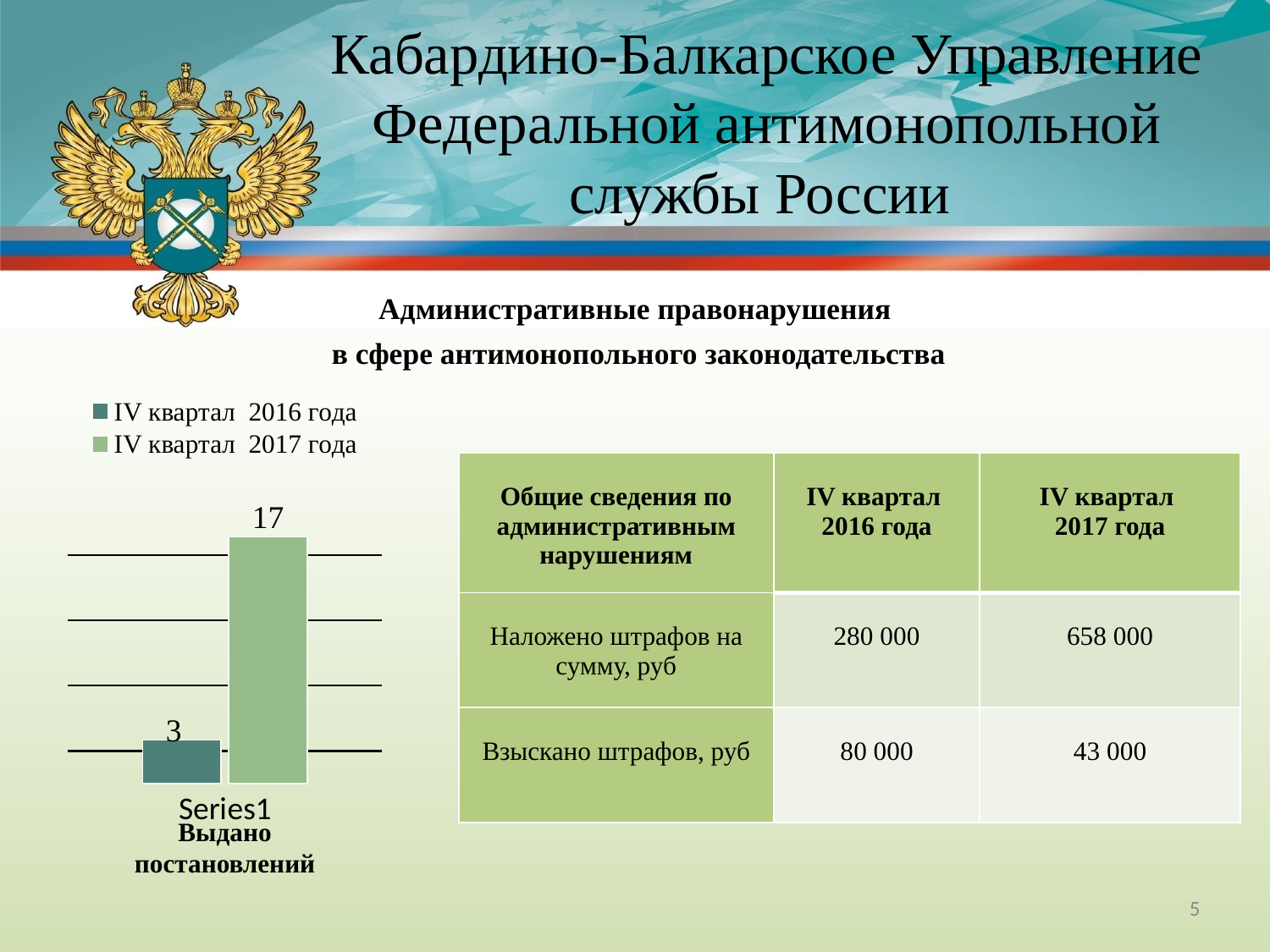
Which series has the lower bar in the chart? IV квартал 2016 года How many categories are shown on the x axis of the chart? 1 What is the value for IV квартал 2016 года in the bar chart? 3 What kind of chart is shown on the slide? bar chart What is the value for IV квартал 2017 года in the bar chart? 17 What is the category label shown under the bars in the chart? Series1 Is the bar for IV квартал 2016 года larger or smaller than the bar for IV квартал 2017 года? smaller What is the difference between the IV квартал 2017 года bar and the IV квартал 2016 года bar? 14 Which series has the higher bar in the chart, IV квартал 2016 года or IV квартал 2017 года? IV квартал 2017 года How many series does the chart legend list? 2 What caption appears below the chart describing what the bars represent? Выдано постановлений